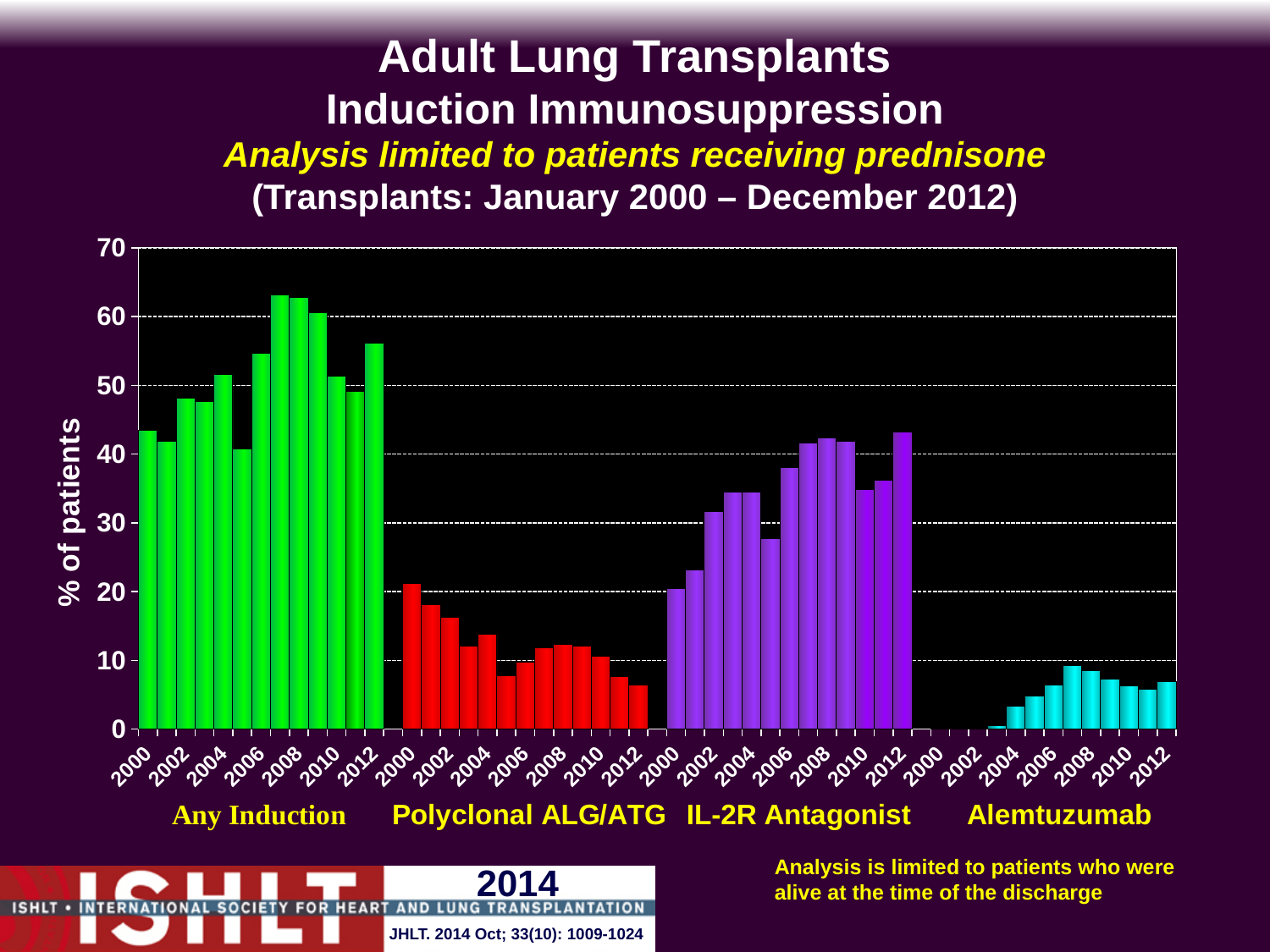
Is the value for Polyclonal ALG/ATG in 2012 greater or less than 10? less Within the Polyclonal ALG/ATG group, which year has the highest value? 2000 Is the value for Alemtuzumab in 2007 greater or less than 10? less Which induction group has the highest percentages overall? Any Induction Is the value for IL-2R Antagonist in 2012 greater or less than 40? greater How many induction immunosuppression groups are shown along the x axis? 4 What is the label on the y axis? % of patients What kind of chart is shown on the slide? bar chart Do the Polyclonal ALG/ATG values generally rise or fall from 2000 to 2012? fall Which is larger in 2012: the IL-2R Antagonist value or the Polyclonal ALG/ATG value? IL-2R Antagonist How many years (bars) are plotted for the Any Induction group? 13